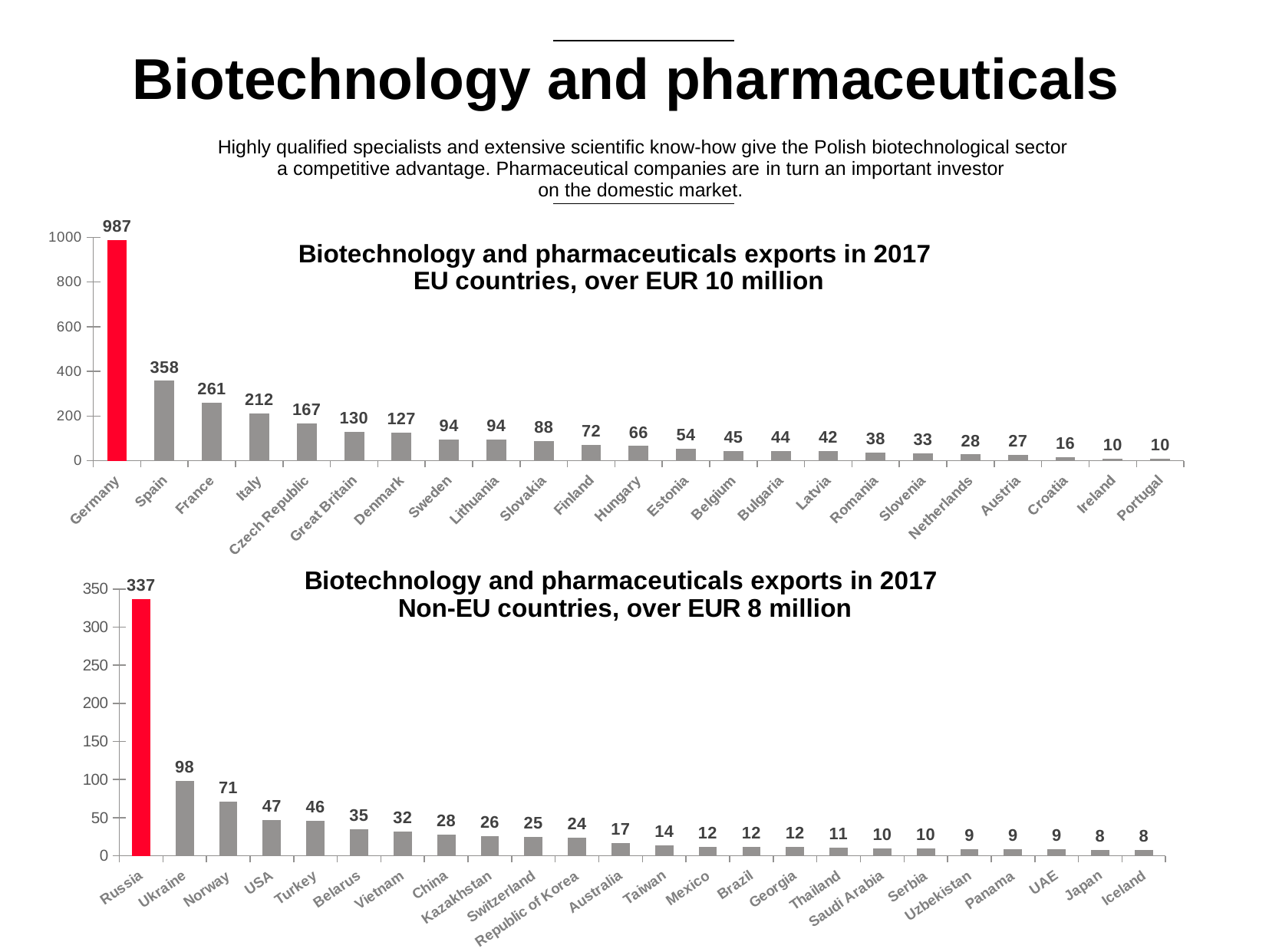
In the EU countries chart, which is larger, Italy or Great Britain? Italy In the Non-EU countries chart, what is the value for Ukraine? 98 In the Non-EU countries chart, what is the difference between Russia and Norway? 266 In the EU countries chart, what is the difference between Spain and France? 97 How many countries are shown in the Non-EU countries chart? 24 In the Non-EU countries chart, which country has the highest value? Russia In the Non-EU countries chart, which is larger, Belarus or Australia? Belarus How many countries are shown in the EU countries chart? 23 In the EU countries chart, what is the value for Germany? 987 In the EU countries chart, what is the value for Czech Republic? 167 In the EU countries chart, do the values rise or fall from left to right? Fall What type of chart is the Non-EU countries chart? Bar chart